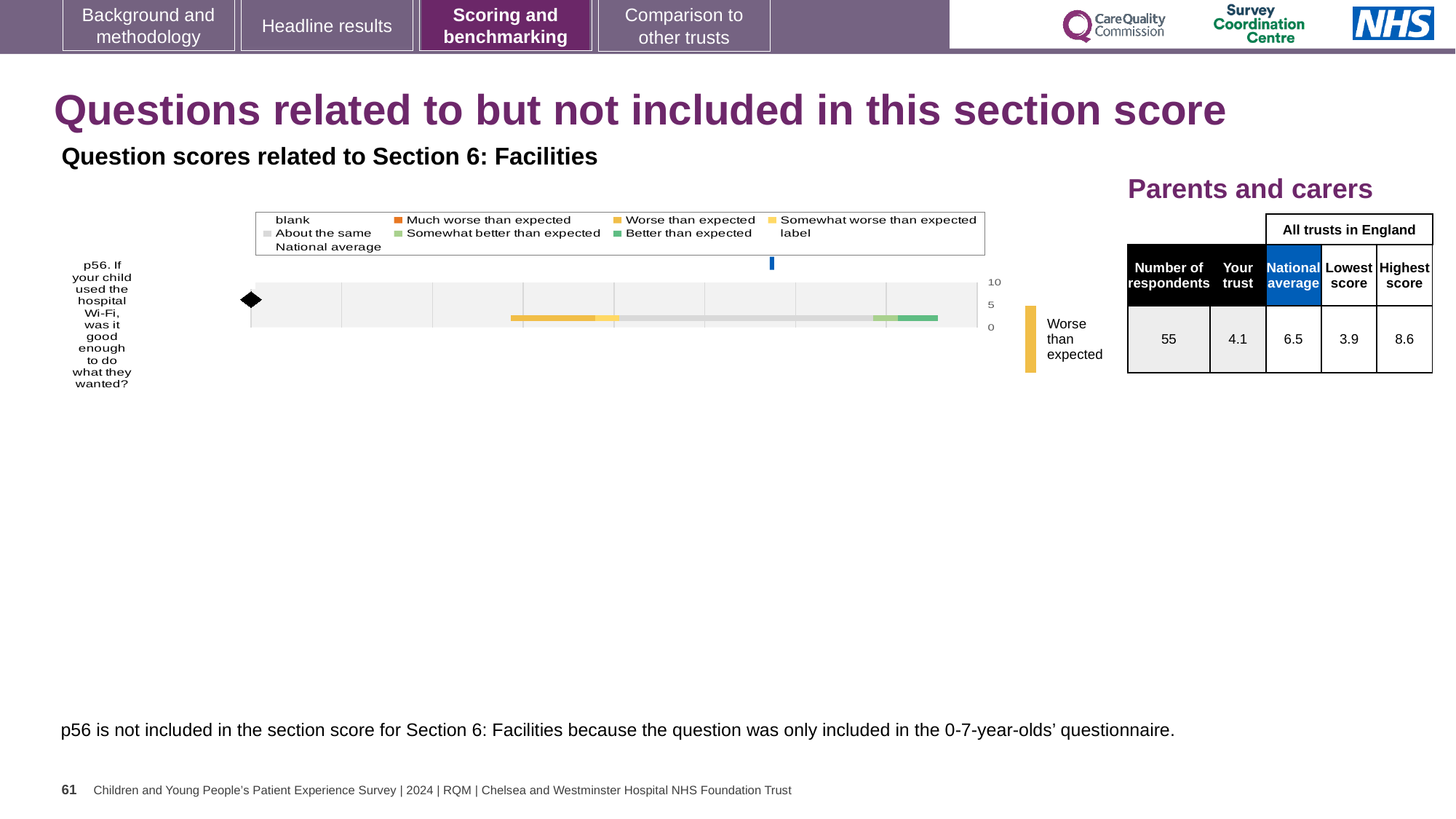
Which question is plotted in the chart? p56. If your child used the hospital Wi-Fi, was it good enough to do what they wanted? What is the lowest score among all trusts in England for p56? 3.9 Which is larger for p56, the trust's score or the national average? National average What is the highest score among all trusts in England for p56? 8.6 Is the trust's score for p56 greater or less than 5? less What is the 'Your trust' score for p56? 4.1 What is the difference between the highest and lowest scores for p56? 4.7 What rating label is shown to the right of the chart for p56? Worse than expected What kind of chart is used to show the p56 question score? bar chart What is the national average score for p56? 6.5 How many questions are plotted in the chart? 1 How many respondents answered p56? 55